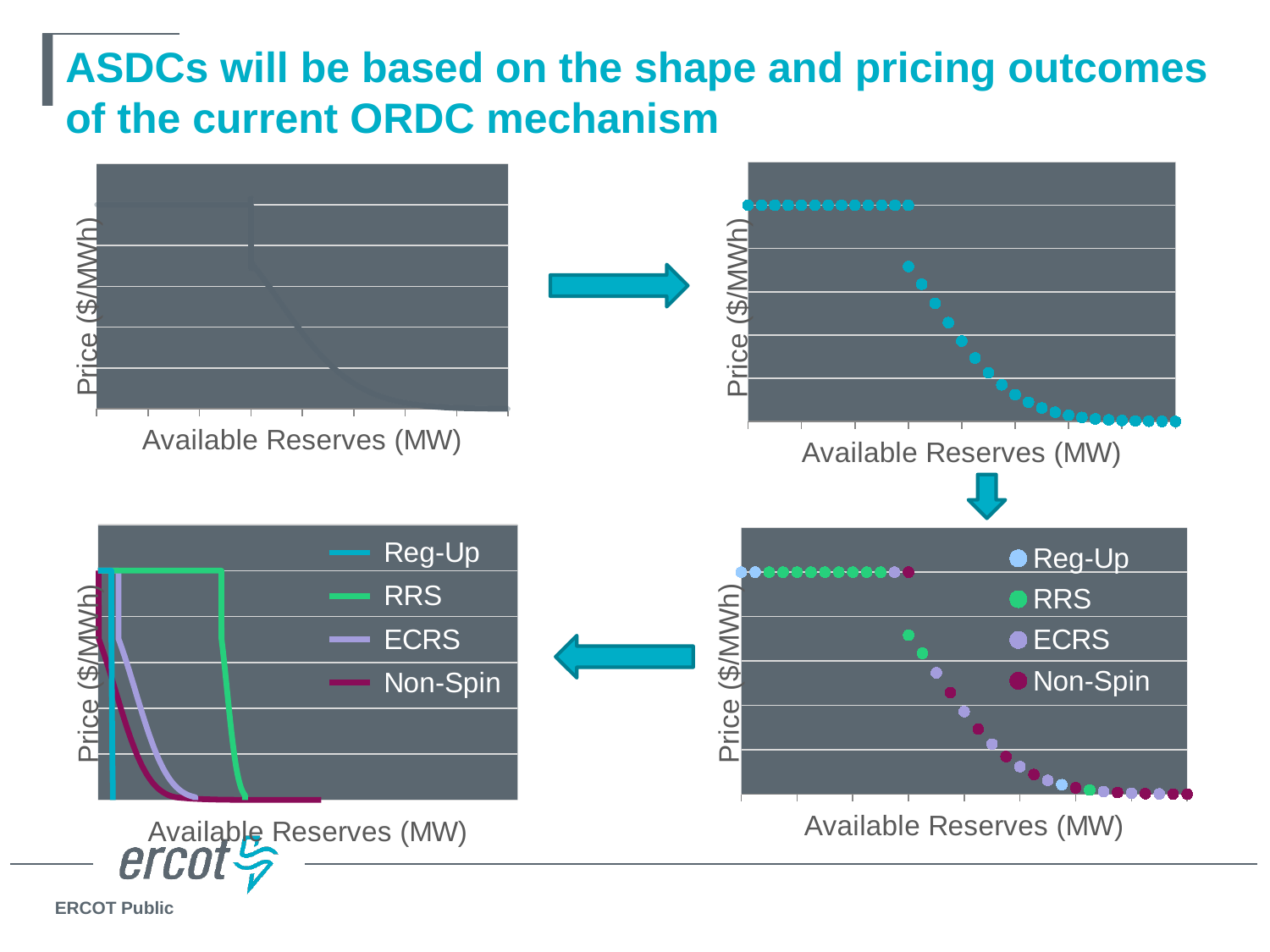
In the bottom-left chart, do the prices rise or fall as available reserves increase? fall What kind of chart is the top-right chart? scatter chart What is the y-axis label of the bottom-right chart? Price ($/MWh) What kind of chart is the top-left chart? line chart In the top-right chart, do the prices rise or fall as available reserves increase? fall In the top-left chart, does the price rise or fall as available reserves increase? fall How many series does the legend of the bottom-left chart list? 4 What are the legend entries of the bottom-right chart? Reg-Up, RRS, ECRS, Non-Spin What kind of chart is the bottom-left chart? line chart In the bottom-left chart, which series stays at the top price level over the widest range of available reserves before dropping? RRS How many series does the legend of the bottom-right chart list? 4